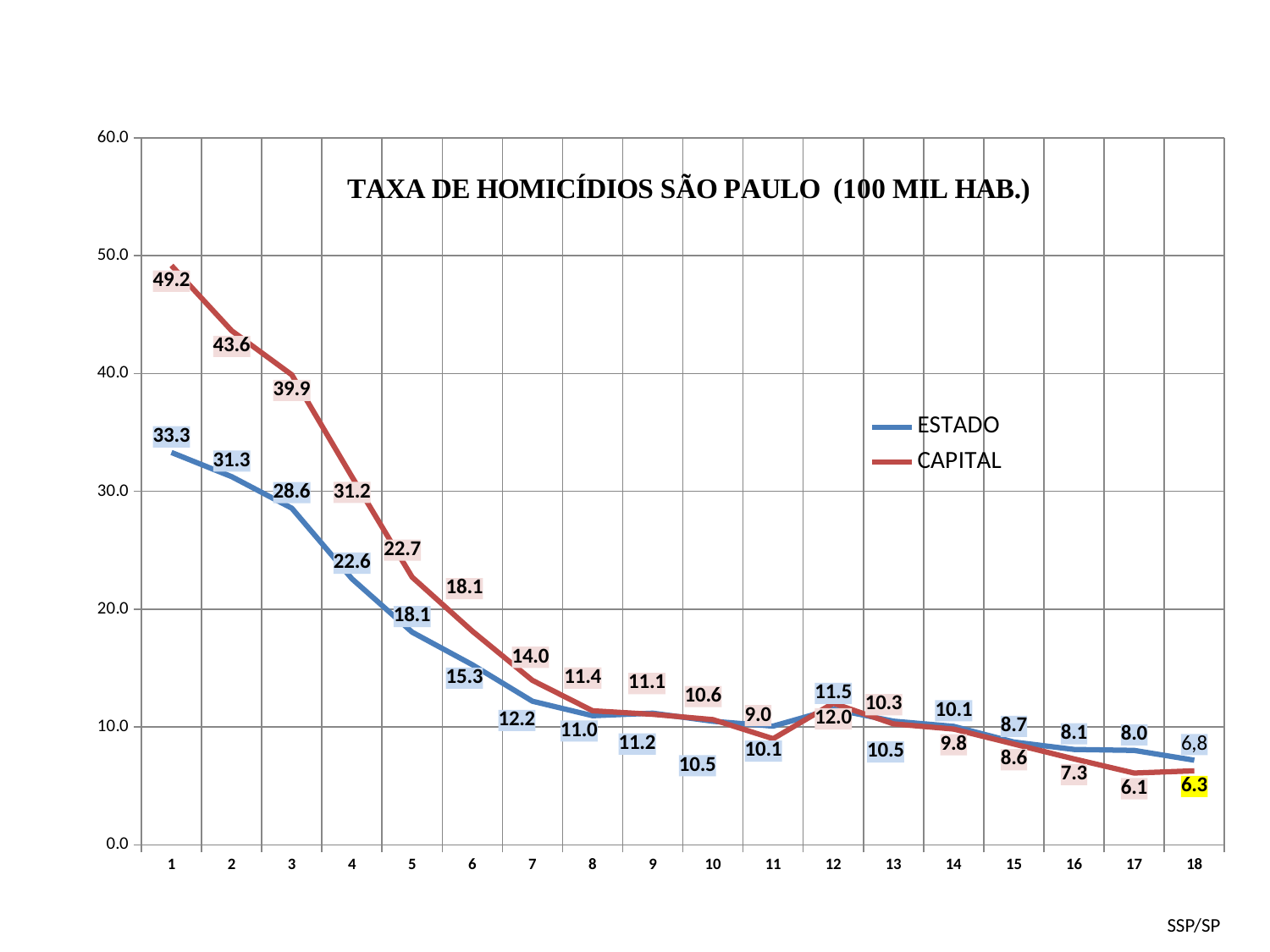
What is the value of CAPITAL at point 17? 6.1 At which point does the CAPITAL series reach its lowest value? 17 What is the value of CAPITAL at point 1? 49.2 How many points are plotted along the x axis for each series? 18 What type of chart is shown on the slide? line chart What is the difference between CAPITAL and ESTADO at point 1? 15.9 How many series does the legend list? 2 At which point does the CAPITAL series reach its highest value? 1 Overall, do the values of the ESTADO series rise or fall from point 1 to point 18? fall What is the title of the chart? TAXA DE HOMICÍDIOS SÃO PAULO (100 MIL HAB.) Which series has the higher value at point 3? CAPITAL What is the value of ESTADO at point 4? 22.6